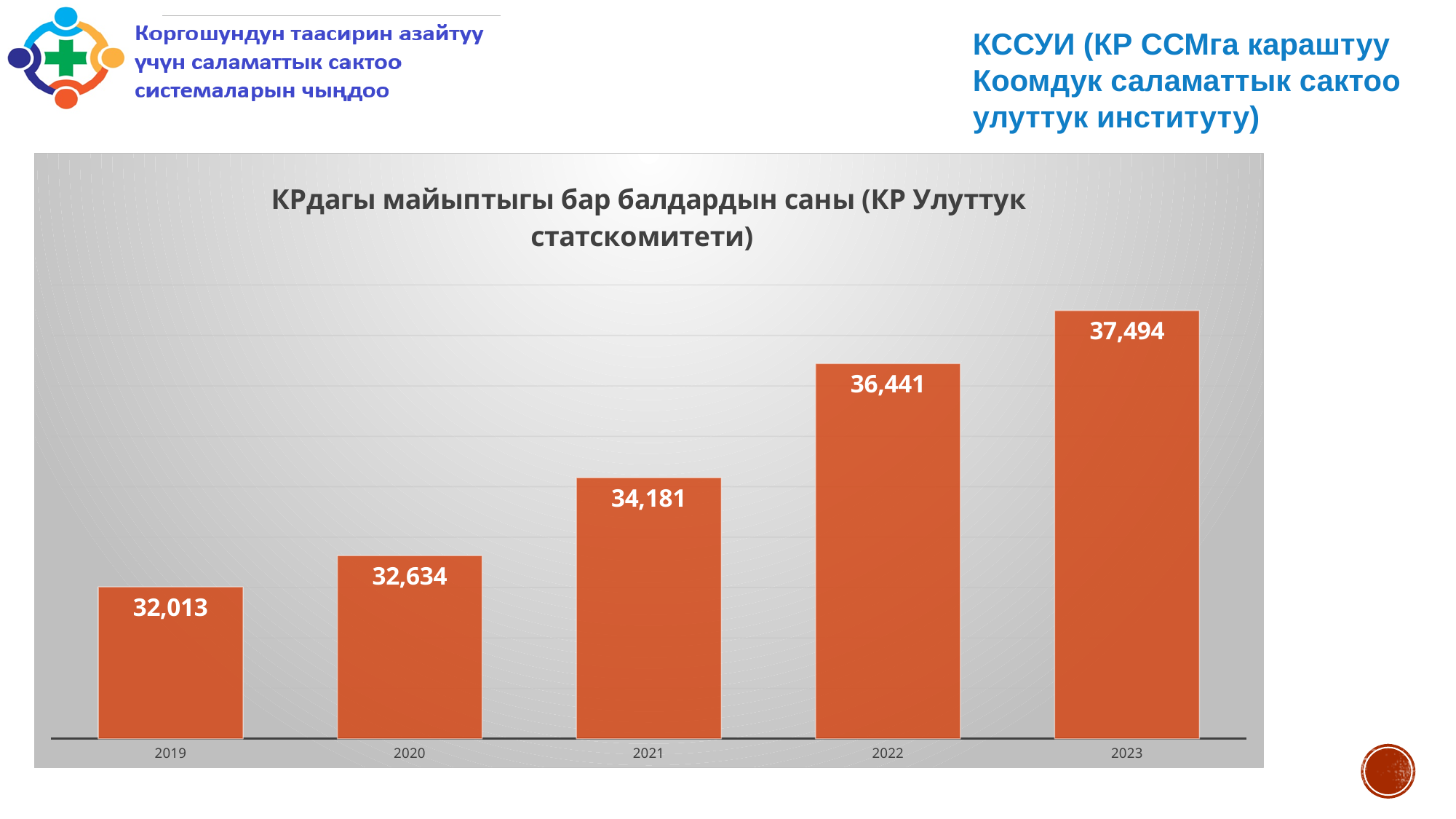
How many years are shown on the x axis? 5 Which year has the lowest value? 2019 What is the difference between the values for 2023 and 2019? 5,481 What kind of chart is this? bar chart What colour are the bars? orange Which is larger, the value for 2020 or the value for 2022? 2022 What is the value for 2019? 32,013 What is the value for 2023? 37,494 What is the difference between the values for 2022 and 2021? 2,260 Do the values rise or fall from 2019 to 2023? rise Which year has the highest value? 2023 What is the value for 2021? 34,181